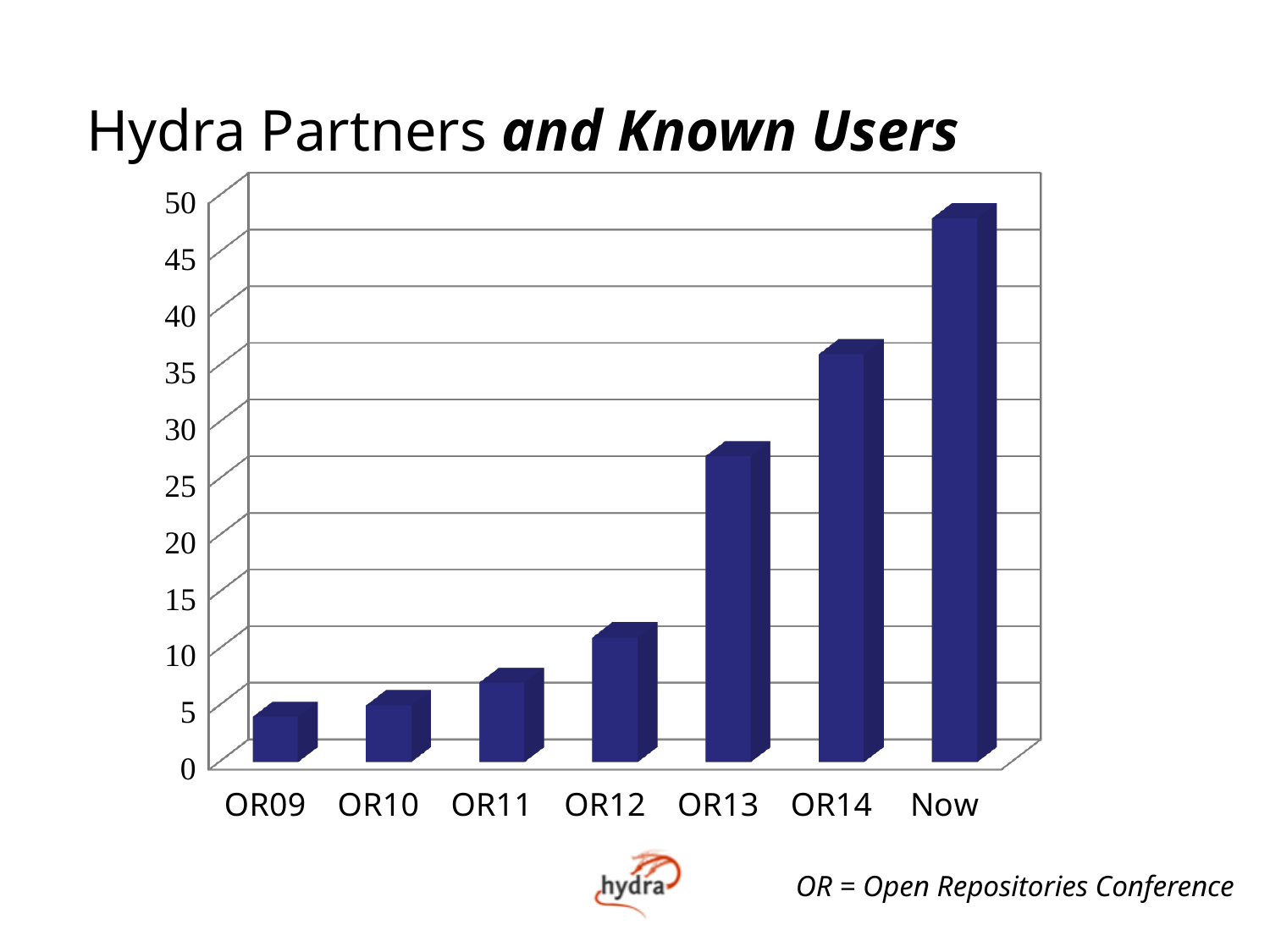
What is the title of the chart? Hydra Partners and Known Users Which category has the highest value? Now Is the value for OR12 greater or less than 15? less Is the value for OR11 greater or less than 10? less How many categories are shown along the x axis? 7 Is the value for Now greater or less than 45? greater Which category has the lowest value? OR09 Which is larger, the value for OR13 or the value for OR14? OR14 What kind of chart is shown on the slide? bar chart Do the values rise or fall from OR09 to Now? rise